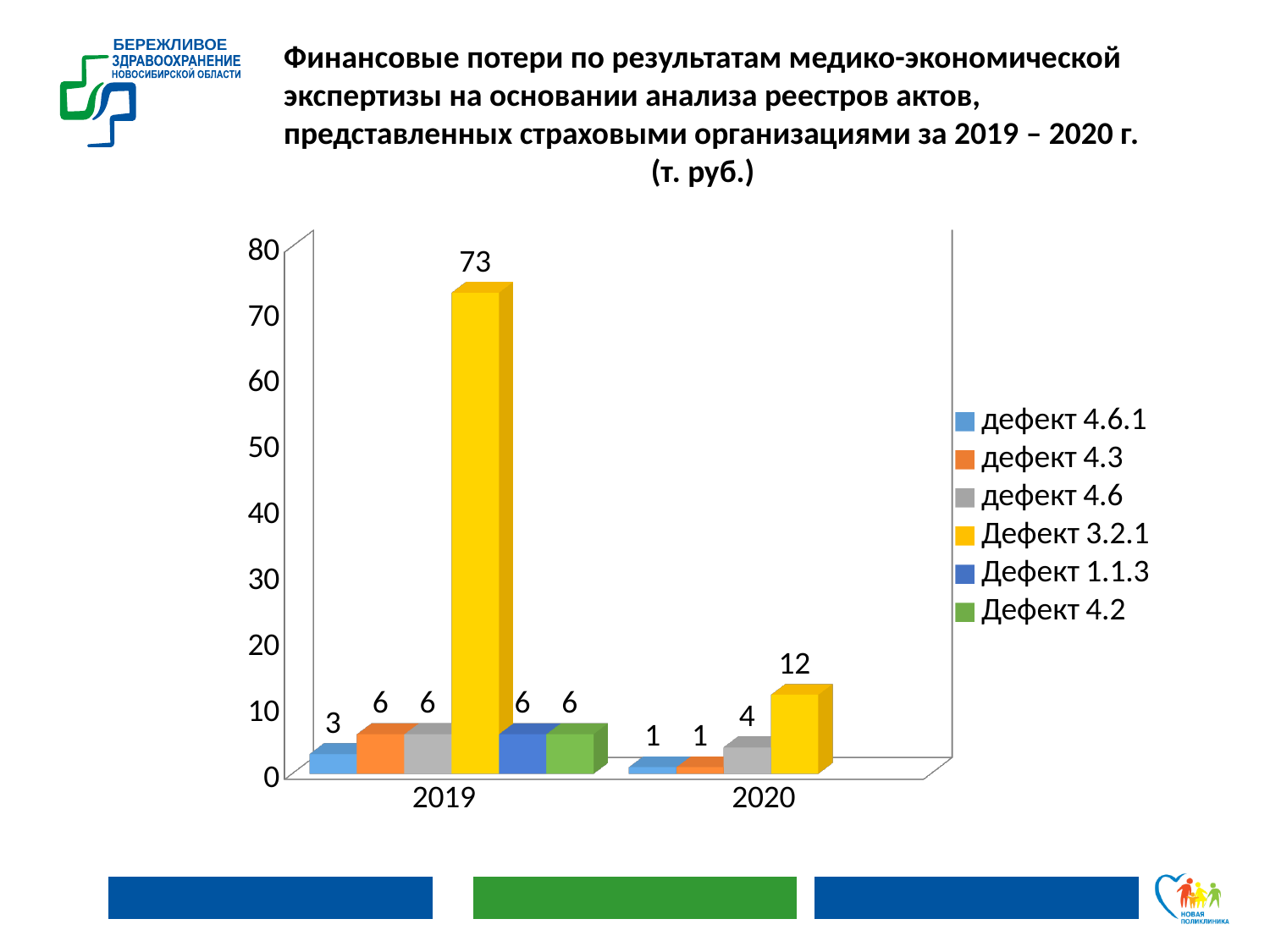
What is the difference between the Дефект 3.2.1 values for 2019 and 2020? 61 Which is larger: дефект 4.6 in 2019 or дефект 4.6 in 2020? дефект 4.6 in 2019 Which series has the lowest value in 2019? дефект 4.6.1 Does the value for Дефект 3.2.1 rise or fall from 2019 to 2020? Fall What is the value for дефект 4.6.1 in 2019? 3 What is the value for Дефект 3.2.1 in 2020? 12 What kind of chart is shown on the slide? Bar chart What is the value for Дефект 3.2.1 in 2019? 73 Is the value for Дефект 3.2.1 in 2019 greater or less than 70? greater How many series does the legend list? 6 Which series has the highest value in 2019? Дефект 3.2.1 What is the value for дефект 4.6 in 2020? 4